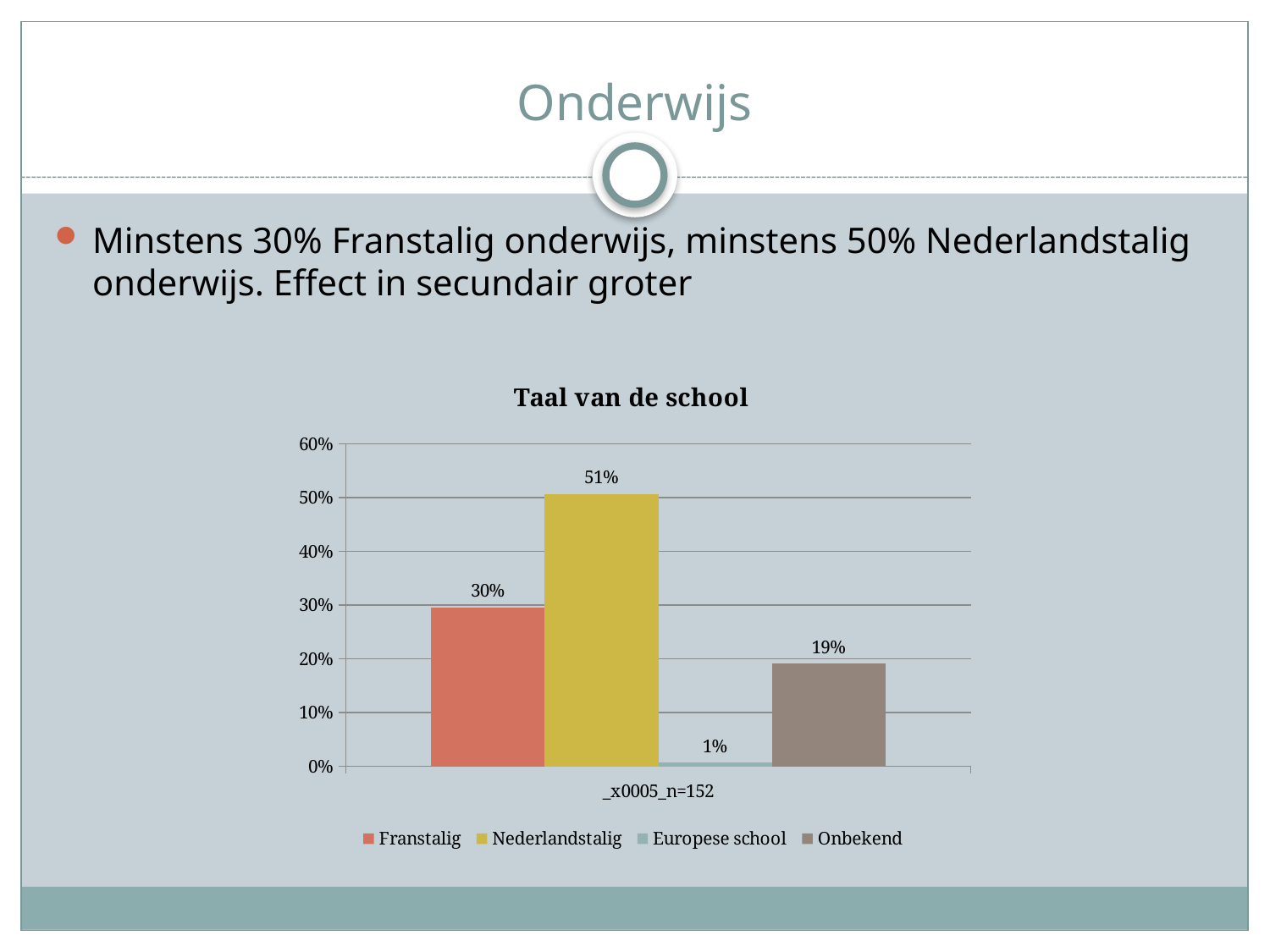
What is the difference between the values for Nederlandstalig and Franstalig? 21% How many series does the legend list? 4 Which is larger, the value for Franstalig or the value for Onbekend? Franstalig What kind of chart is shown on the slide? Bar chart What is the value for Nederlandstalig in the chart? 51% What is the value for Europese school in the chart? 1% Which series has the highest value in the chart? Nederlandstalig What is the value for Franstalig in the chart? 30% What is the value for Onbekend in the chart? 19% What colour is the bar for Nederlandstalig? Yellow Which series has the lowest value in the chart? Europese school What is the title of the chart? Taal van de school